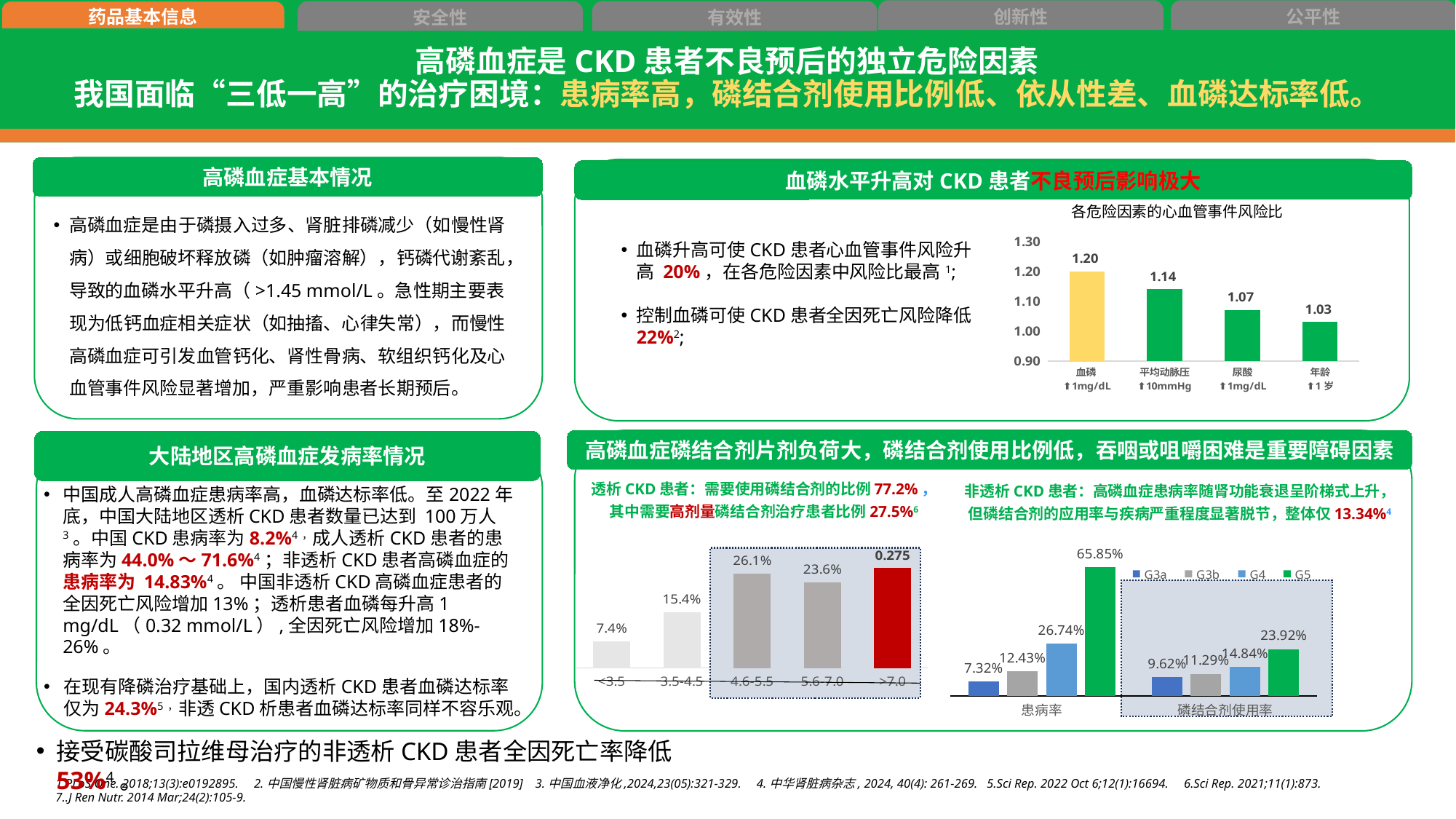
In the chart titled 各危险因素的心血管事件风险比, how many categories are plotted? 4 In the chart titled 各危险因素的心血管事件风险比, which category has the lowest value? 年龄 In the chart titled 各危险因素的心血管事件风险比, what is the value for 血磷? 1.20 In the chart titled 各危险因素的心血管事件风险比, do the values rise or fall from left to right? fall In the grouped bar chart at the bottom right of the slide, what is the 患病率 value for G5? 65.85% In the grouped bar chart at the bottom right of the slide, how many series does the legend list? 4 In the bar chart at the bottom middle of the slide, which category has the highest value? >7.0 What type of chart is the chart titled 各危险因素的心血管事件风险比? bar chart In the chart titled 各危险因素的心血管事件风险比, what is the difference between the values for 血磷 and 平均动脉压? 0.06 In the bar chart at the bottom middle of the slide, which is larger, the value for 4.6-5.5 or the value for 5.6-7.0? 4.6-5.5 In the grouped bar chart at the bottom right of the slide, what is the 磷结合剂使用率 value for G3a? 9.62% In the bar chart at the bottom middle of the slide, what is the value for the 3.5-4.5 category? 15.4%